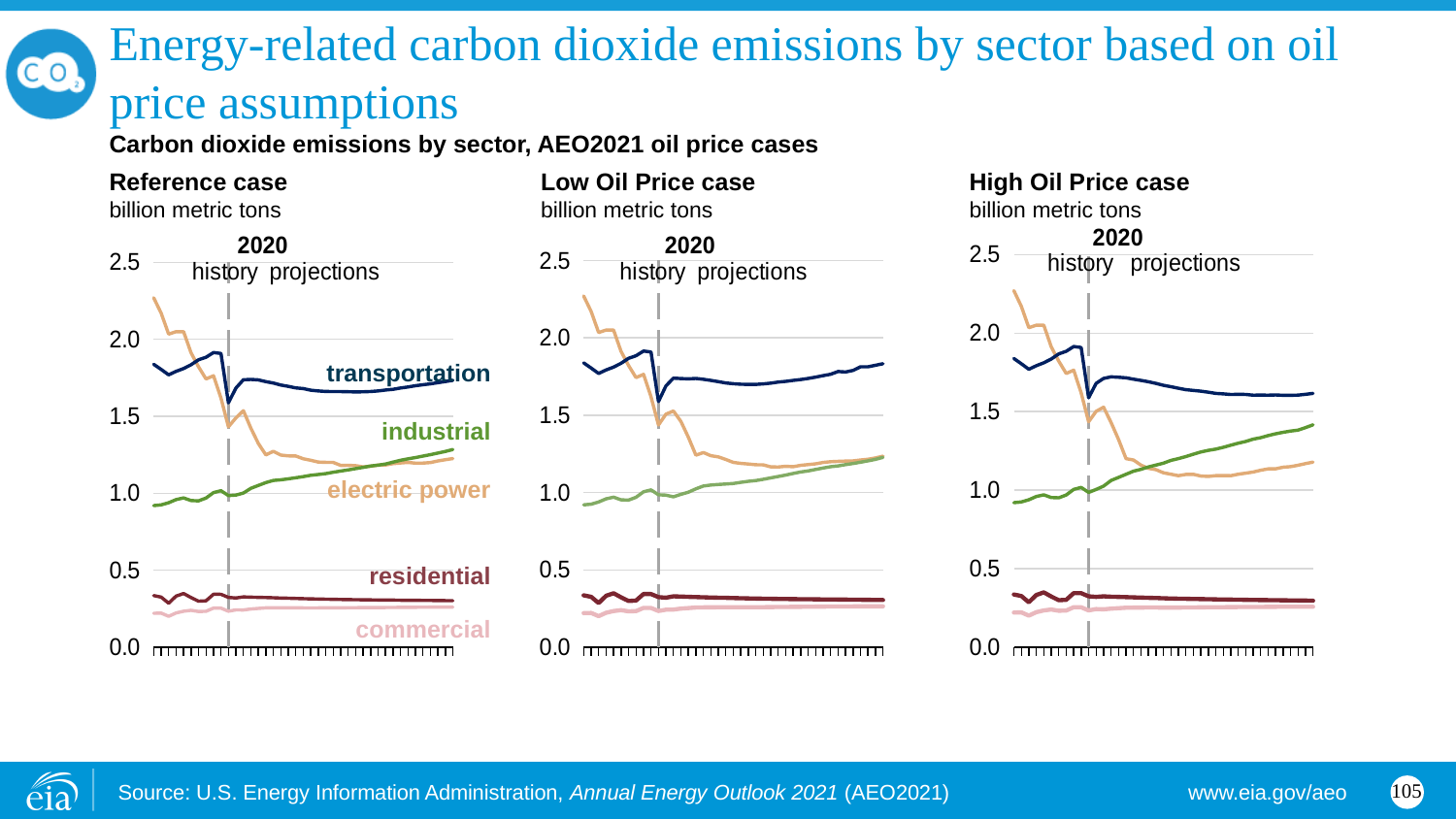
In the Reference case chart, which sector has the highest emissions at the end of the projection period? transportation In the High Oil Price case chart, does the industrial line rise or fall over the projection period? rise In the Reference case chart, does the electric power line rise or fall over the history period? fall In the Reference case chart, is the transportation value at the end of the projections greater or less than 1.5? greater In the High Oil Price case chart, is the transportation value at the end of the projections greater or less than 2.0? less What year does the dashed vertical line mark in each chart? 2020 In the High Oil Price case chart, at the end of the projections, which is larger: industrial or electric power? industrial In the Reference case chart, which sector has the lowest emissions throughout the period? commercial In the Reference case chart, how many sectors are labeled? 5 In the Reference case chart, is the residential value at the end of the projections greater or less than 0.5? less How many charts are shown on the slide? 3 What kind of chart is used on this slide for the Reference case? line chart